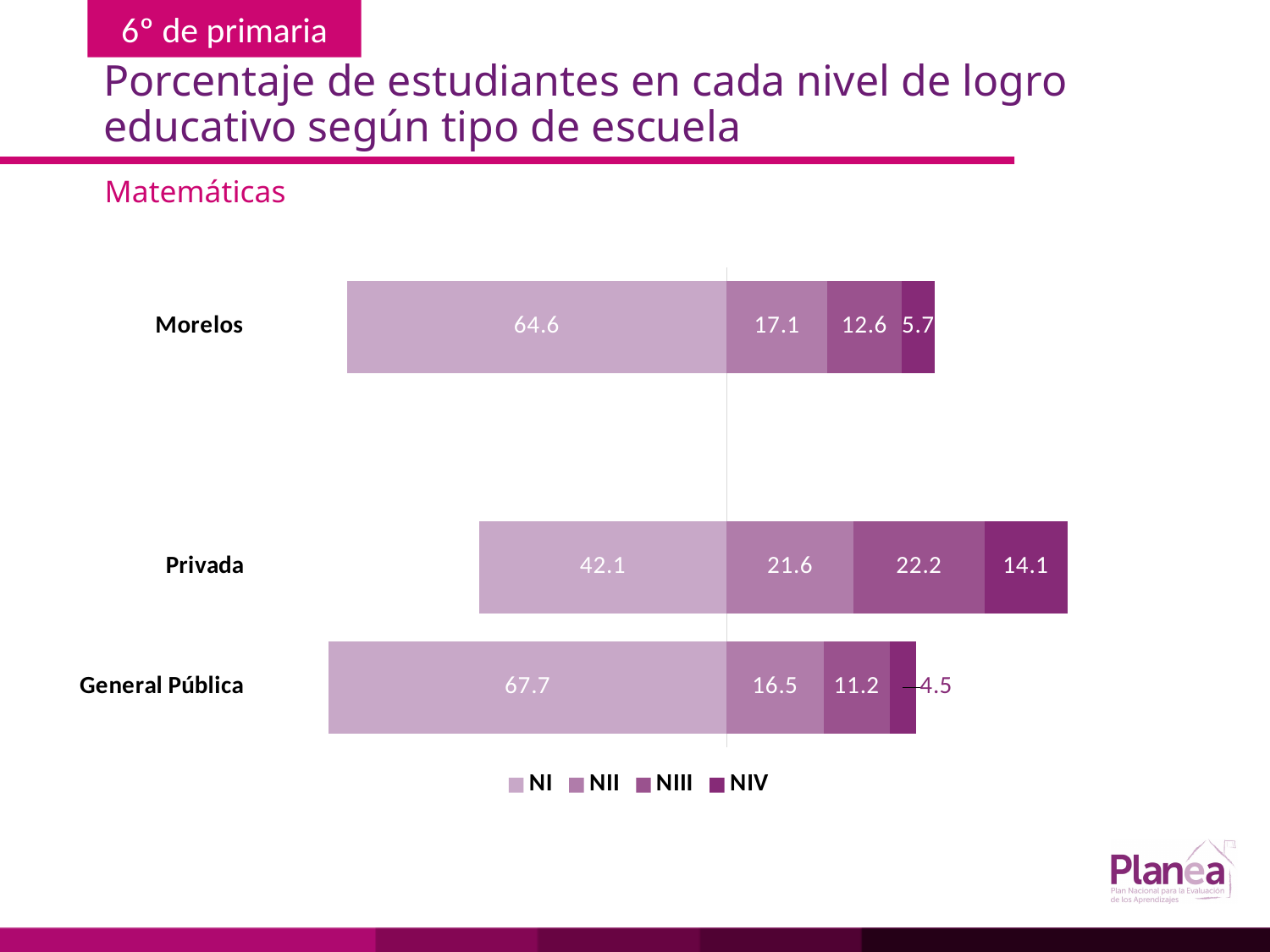
Which category has the highest NI value? General Pública What is the NII value for General Pública? 16.5 Which category has the lowest NIV value? General Pública What is the total of the stacked bar for Privada? 100 What is the NI value for Morelos? 64.6 What is the NIII value for Morelos? 12.6 What is the difference between the NI values for General Pública and Privada? 25.6 What kind of chart is shown on the slide? Stacked bar chart How many series does the legend list? 4 How many categories are shown on the chart? 3 What is the NIV value for Privada? 14.1 Which is larger, the NIII value for Privada or the NIII value for Morelos? Privada